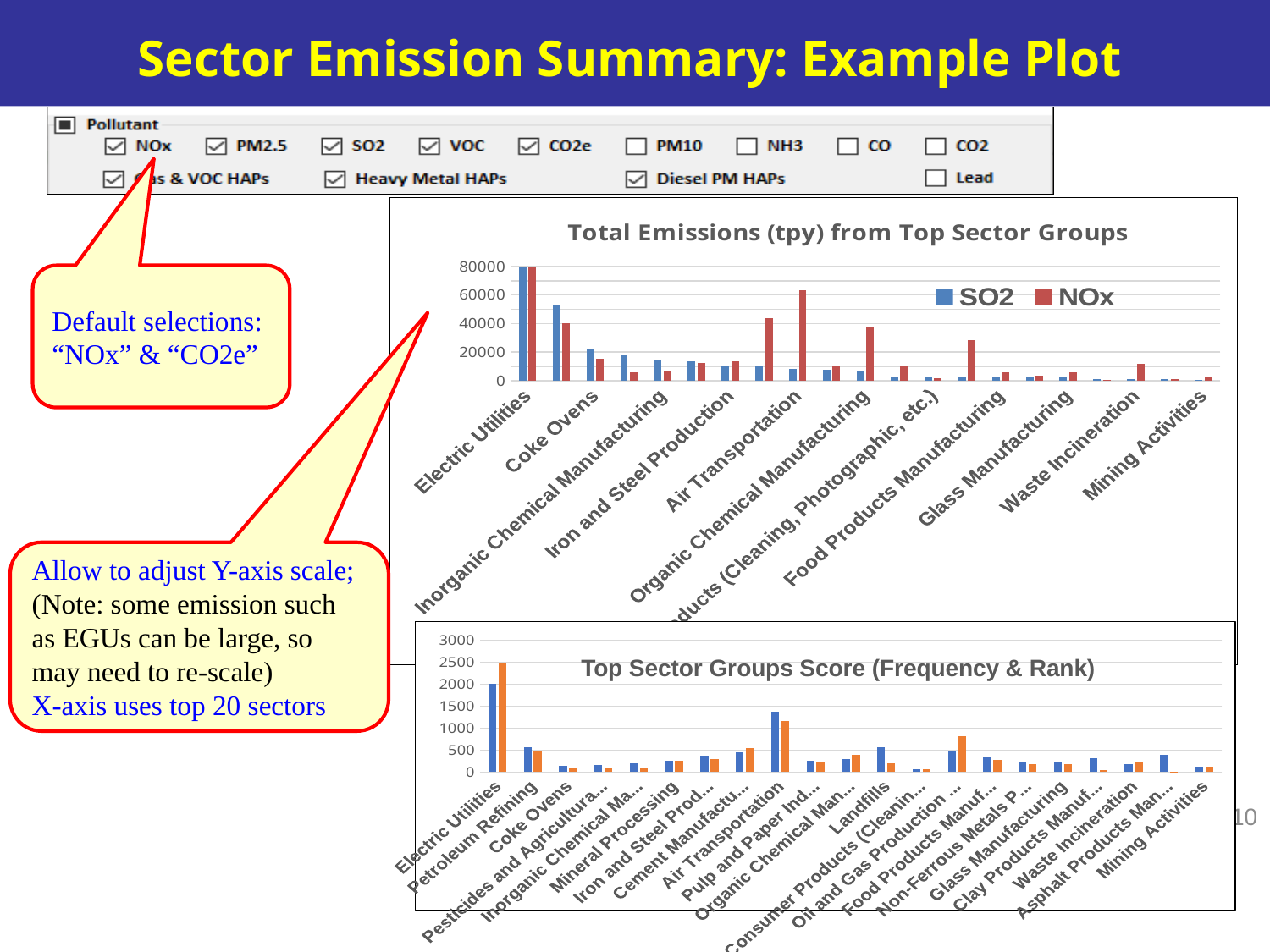
What are the two series named in the legend of the 'Total Emissions (tpy) from Top Sector Groups' chart? SO2 and NOx In the 'Total Emissions (tpy) from Top Sector Groups' chart, which is larger for Coke Ovens, SO2 or NOx? SO2 What type of chart is the 'Total Emissions (tpy) from Top Sector Groups' chart? bar chart In the 'Top Sector Groups Score (Frequency & Rank)' chart, is the blue bar for Air Transportation greater or less than 1000? greater In the 'Total Emissions (tpy) from Top Sector Groups' chart, is the SO2 value for Coke Ovens greater or less than 40000? less In the 'Total Emissions (tpy) from Top Sector Groups' chart, is the SO2 value for Electric Utilities greater or less than 60000? greater In the 'Top Sector Groups Score (Frequency & Rank)' chart, which sector has the highest value? Electric Utilities How many series does the legend of the 'Total Emissions (tpy) from Top Sector Groups' chart list? 2 What type of chart is the 'Top Sector Groups Score (Frequency & Rank)' chart? bar chart In the 'Total Emissions (tpy) from Top Sector Groups' chart, which sector has the highest SO2 value? Electric Utilities